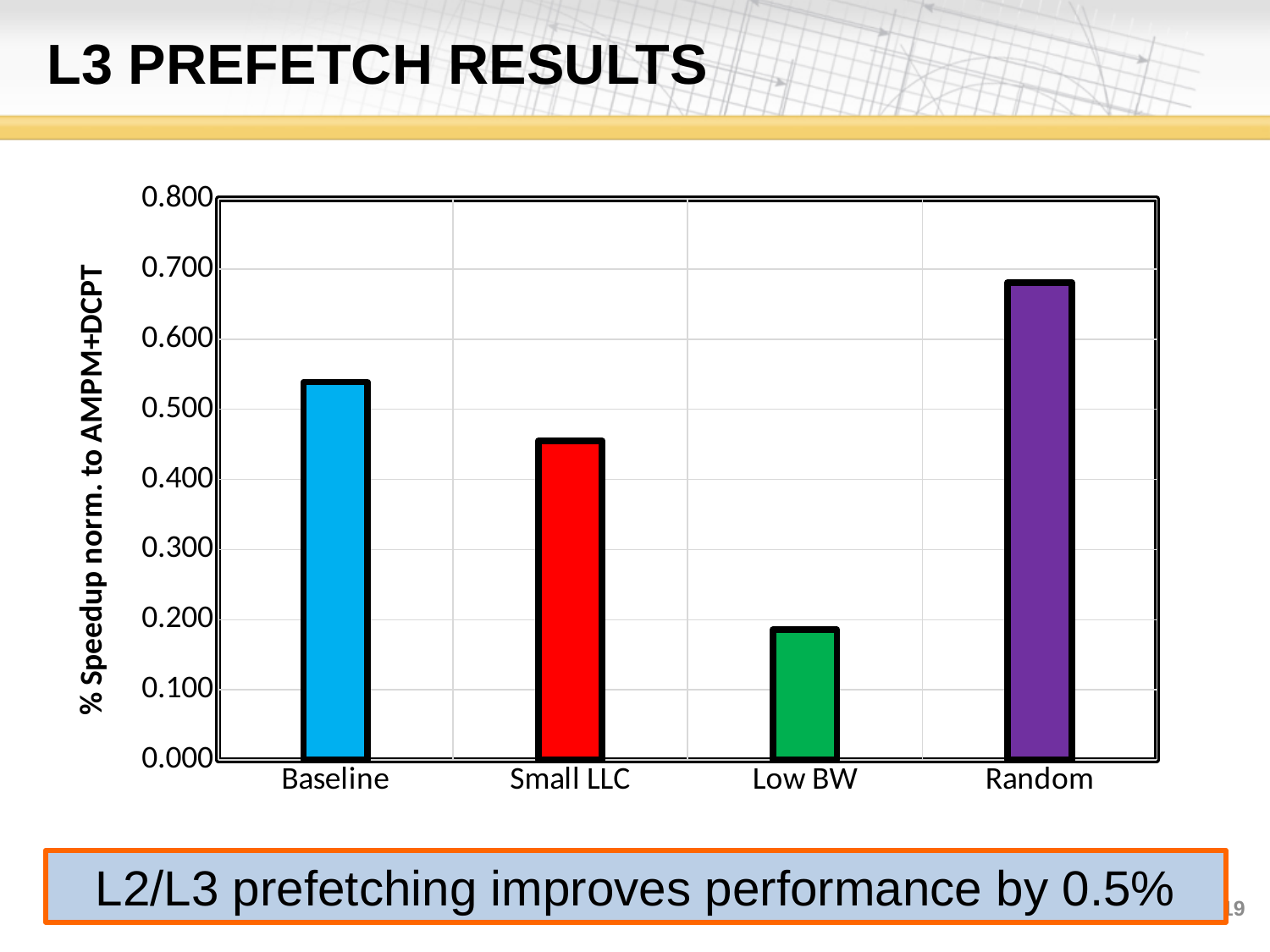
Which is larger, the value for Baseline or the value for Small LLC? Baseline Is the value for Random greater or less than 0.600? greater What colour is the bar for Low BW? green Which category has the lowest value in the chart? Low BW What is the label of the y axis of the chart? % Speedup norm. to AMPM+DCPT Which is larger, the value for Low BW or the value for Random? Random Is the value for Baseline greater or less than 0.500? greater Is the value for Small LLC greater or less than 0.500? less How many categories are shown on the x axis of the chart? 4 Which category has the highest value in the chart? Random What kind of chart is shown on the slide? bar chart